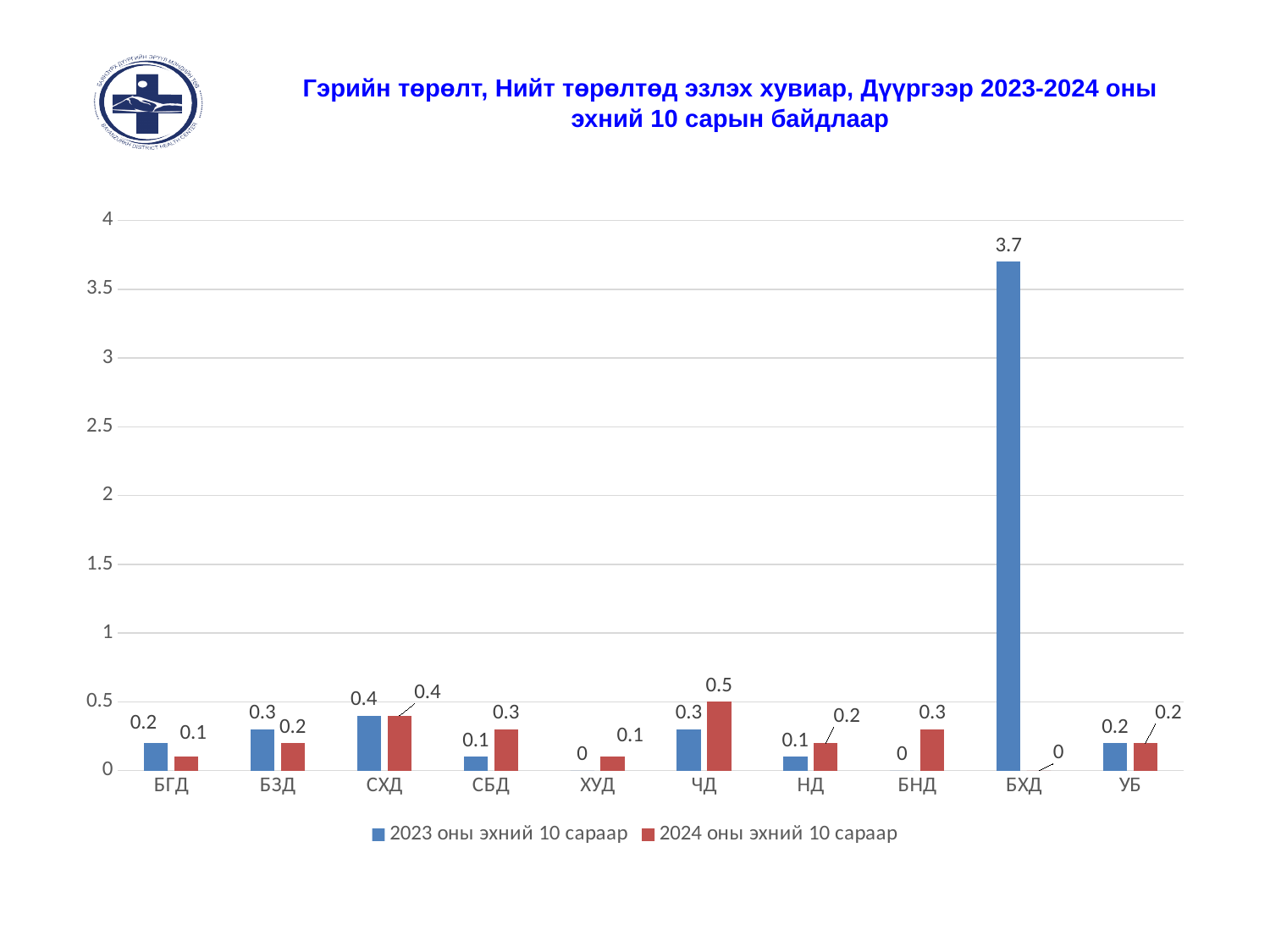
What is the difference between the 2023 and 2024 values for БХД? 3.7 Which category has the highest value in the 2024 оны эхний 10 сараар series? ЧД What is the difference between the 2024 and 2023 values for СБД? 0.2 How many categories are shown on the x axis? 10 Is the value for БХД in the 2023 оны эхний 10 сараар series greater or less than 3.5? greater What is the value for БХД in the 2023 оны эхний 10 сараар series? 3.7 For ЧД, which series has the larger value, 2023 оны эхний 10 сараар or 2024 оны эхний 10 сараар? 2024 оны эхний 10 сараар Which category has the highest value in the 2023 оны эхний 10 сараар series? БХД How many series does the legend list? 2 What kind of chart is shown on the slide? Bar chart What is the value for ЧД in the 2024 оны эхний 10 сараар series? 0.5 What is the value for БНД in the 2023 оны эхний 10 сараар series? 0